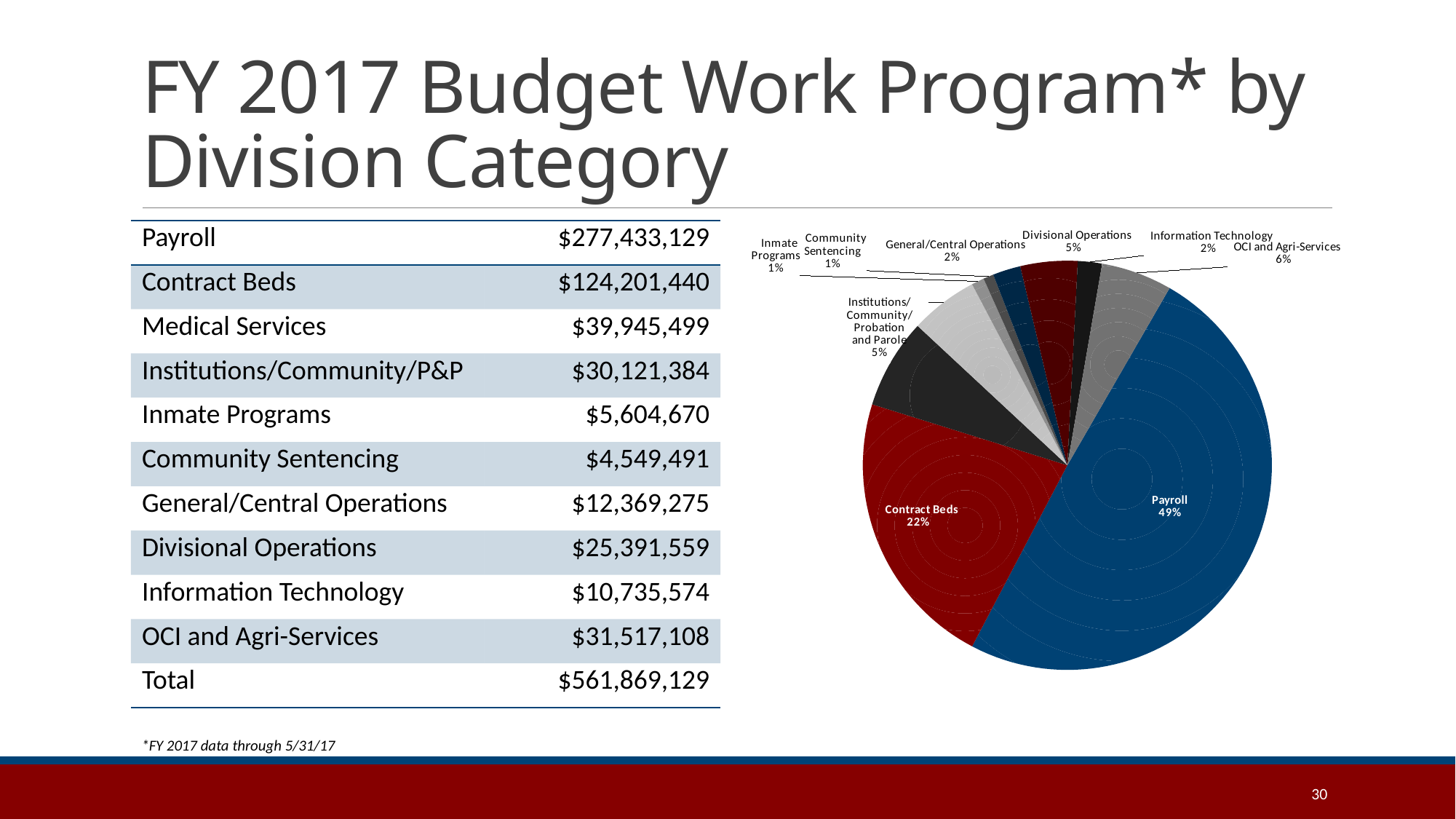
What share of the pie chart does Contract Beds represent? 22% What colour is the Payroll slice in the pie chart? blue What percentage is shown for OCI and Agri-Services in the pie chart? 6% What share of the pie chart does Payroll represent? 49% What percentage is shown for Inmate Programs in the pie chart? 1% What type of chart is shown on the slide? pie chart What percentage is shown for Information Technology in the pie chart? 2% Which category has the largest slice in the pie chart? Payroll What is the difference in percentage points between the Payroll and Contract Beds slices? 27% Which is larger in the pie chart, Contract Beds or OCI and Agri-Services? Contract Beds What percentage is shown for Community Sentencing in the pie chart? 1% What percentage is shown for Divisional Operations in the pie chart? 5%